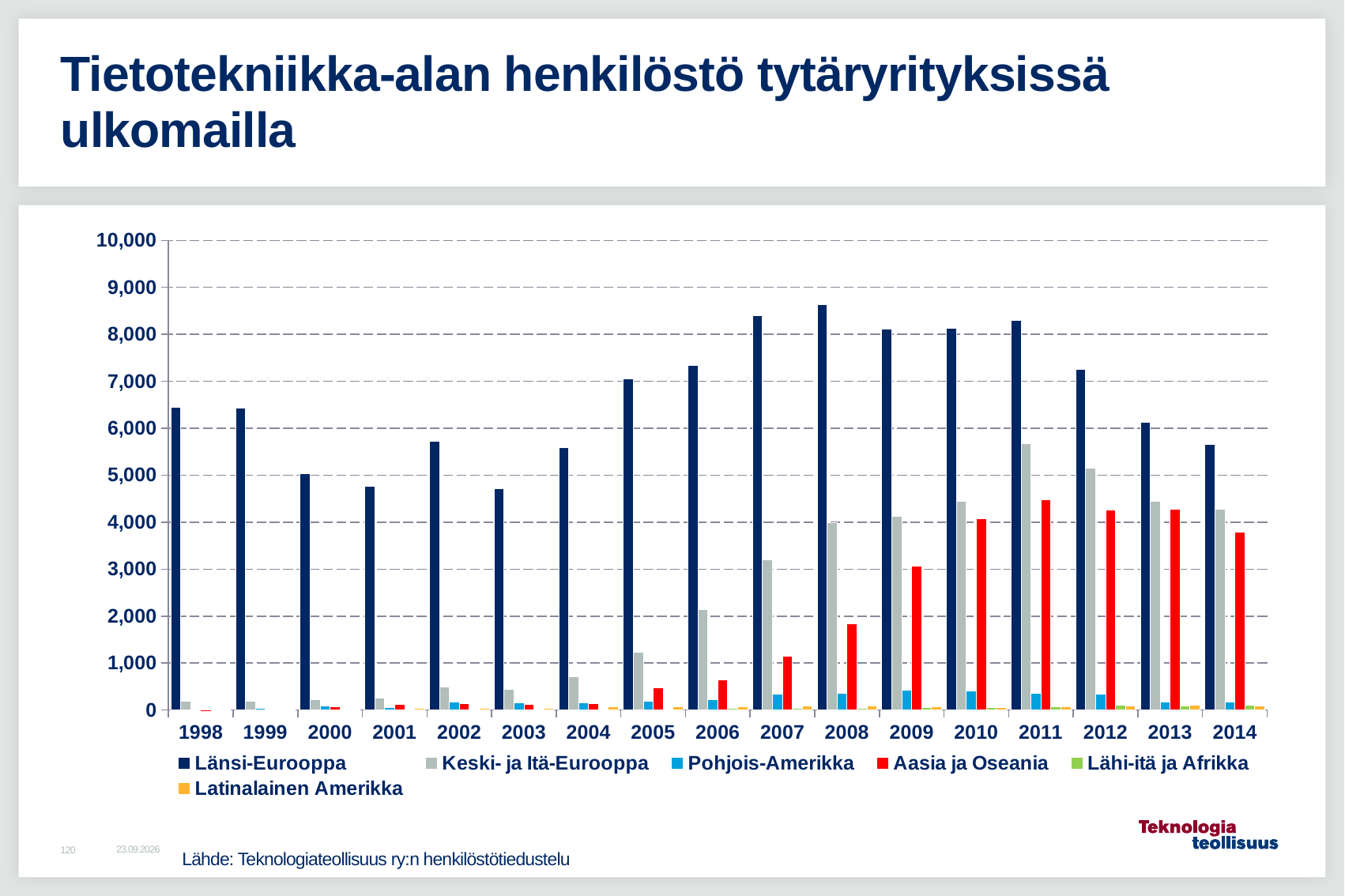
Is the value for Aasia ja Oseania in 2014 greater or less than 4,000? less In which year is the Keski- ja Itä-Eurooppa bar the tallest? 2011 How many years are shown on the x axis of the chart? 17 In which year is the Länsi-Eurooppa bar the tallest? 2008 What kind of chart is shown on the slide? bar chart What colour represents Aasia ja Oseania in the chart? red Is the value for Länsi-Eurooppa in 2008 greater or less than 8,000? greater Is the value for Länsi-Eurooppa in 2003 greater or less than 5,000? less In 2014, which is larger: Keski- ja Itä-Eurooppa or Aasia ja Oseania? Keski- ja Itä-Eurooppa How many series does the chart's legend list? 6 Do the Aasia ja Oseania values rise or fall from 2005 to 2011? rise In which year is the Aasia ja Oseania bar the tallest? 2011